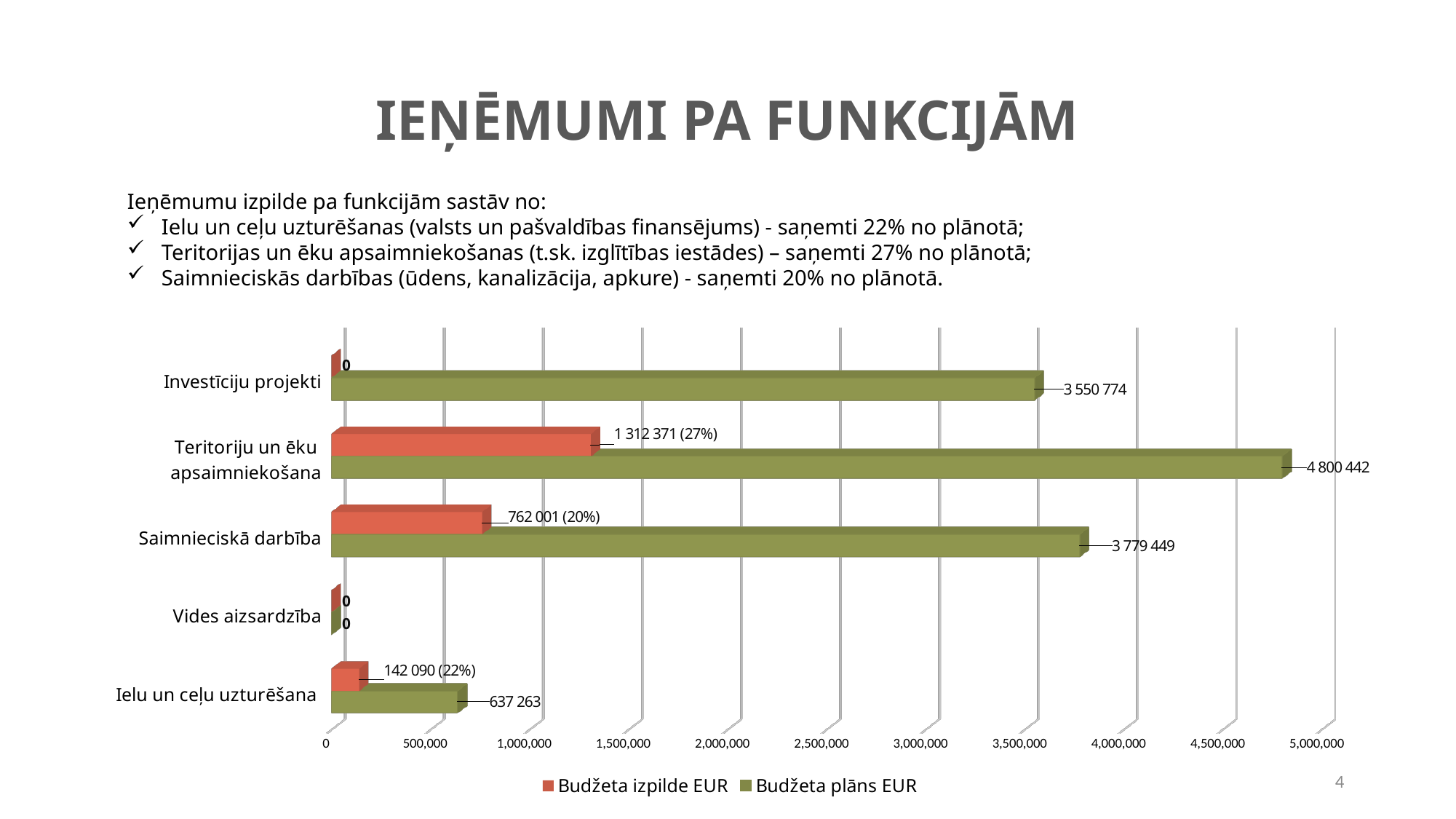
What is the Budžeta plāns EUR value for Teritoriju un ēku apsaimniekošana? 4 800 442 Which is larger: the Budžeta plāns EUR value for Saimnieciskā darbība or for Investīciju projekti? Saimnieciskā darbība What is the difference between the Budžeta plāns EUR and Budžeta izpilde EUR values for Ielu un ceļu uzturēšana? 495 173 How many categories are shown on the chart? 5 What is the Budžeta izpilde EUR value for Saimnieciskā darbība? 762 001 (20%) What is the Budžeta izpilde EUR value for Investīciju projekti? 0 Is the Budžeta plāns EUR value for Investīciju projekti greater or less than 3,000,000? greater How many series does the legend list? 2 What kind of chart is shown on the slide? bar chart Which category has the highest Budžeta izpilde EUR value? Teritoriju un ēku apsaimniekošana Which category has the highest Budžeta plāns EUR value? Teritoriju un ēku apsaimniekošana What is the Budžeta plāns EUR value for Ielu un ceļu uzturēšana? 637 263